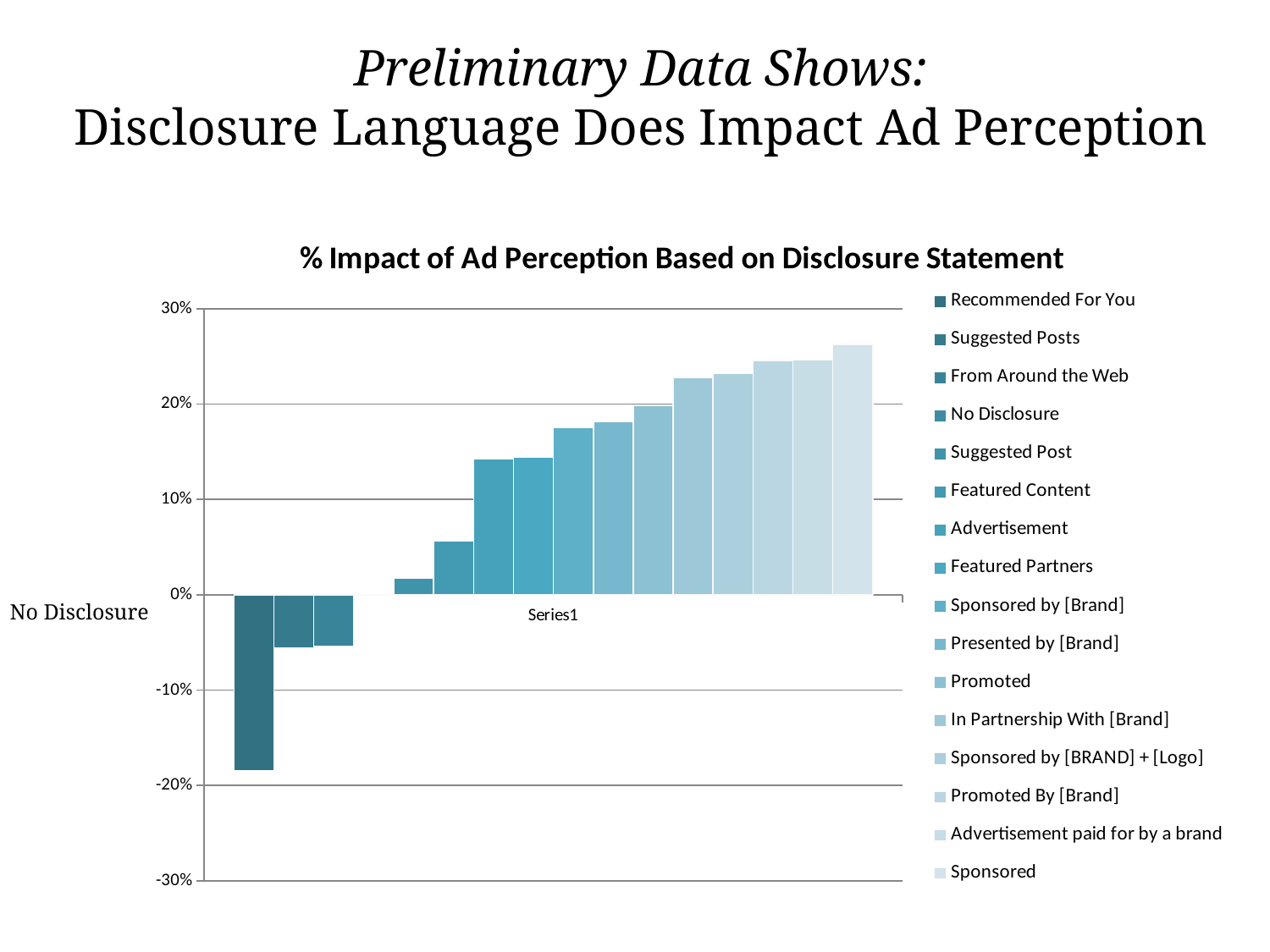
What kind of chart is shown on the slide? bar chart What is the title of the chart? % Impact of Ad Perception Based on Disclosure Statement Is the value for Advertisement greater or less than 10%? greater Do the bar values rise or fall moving from left to right across the chart? rise Is the value for Featured Content greater or less than 10%? less Which disclosure statement has the lowest value in the chart? Recommended For You Which has the larger value, Advertisement or Featured Content? Advertisement Is the value for Sponsored greater or less than 20%? greater How many series does the chart's legend list? 16 Which disclosure statement has the highest value in the chart? Sponsored